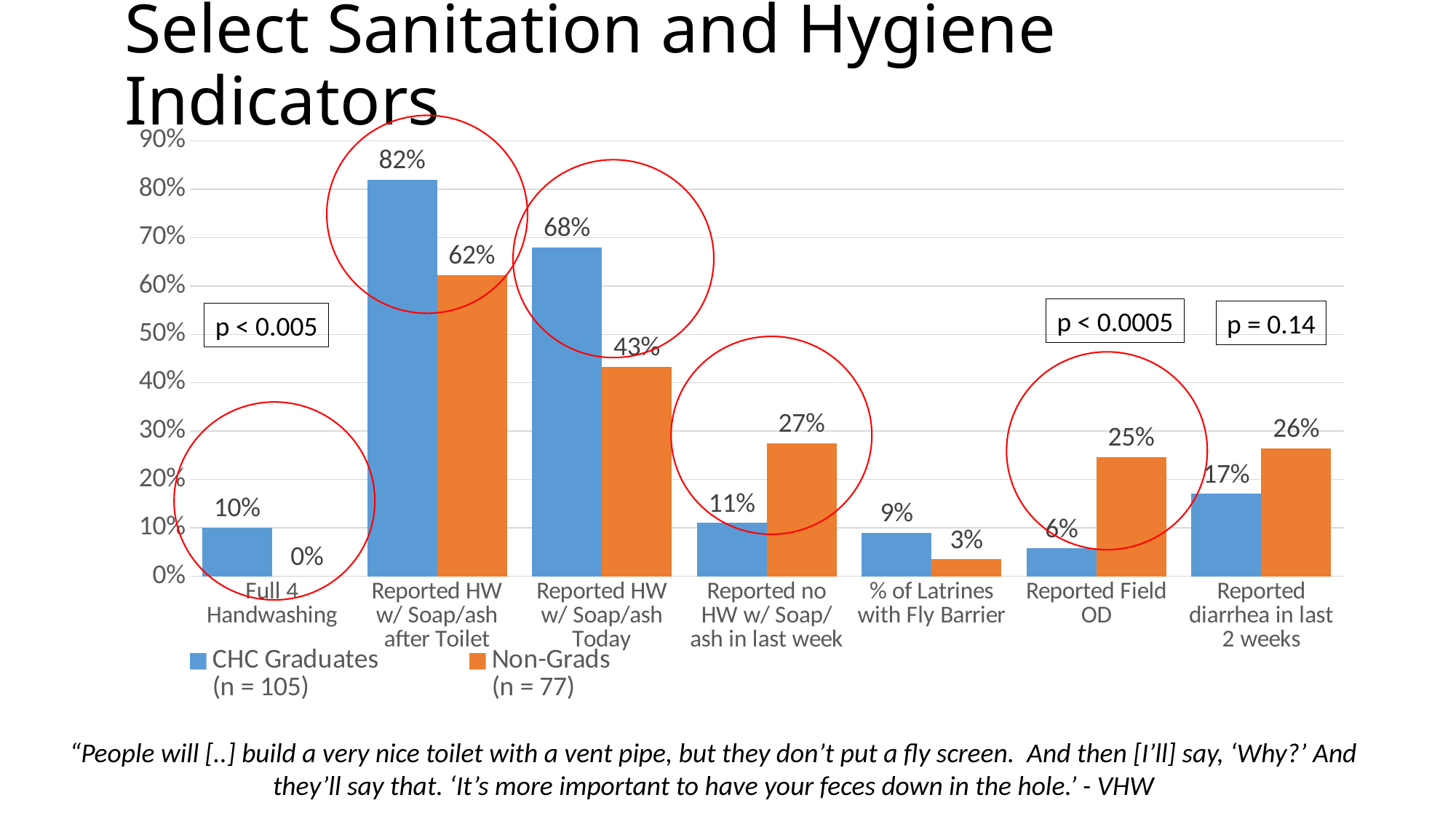
What is the sample size (n) for the CHC Graduates series shown in the legend? 105 What is the difference between CHC Graduates and Non-Grads for Reported HW w/ Soap/ash Today? 25% What is the value for Non-Grads for Full 4 Handwashing? 0% What kind of chart is shown on the slide? Bar chart How many series does the legend list? 2 What is the value for Non-Grads for Reported no HW w/ Soap/ash in last week? 27% Which is larger for Reported Field OD: CHC Graduates or Non-Grads? Non-Grads Which category has the highest value for CHC Graduates? Reported HW w/ Soap/ash after Toilet What is the value for CHC Graduates for Reported HW w/ Soap/ash after Toilet? 82% How many categories are shown on the x axis? 7 Is the value for Non-Grads for Reported HW w/ Soap/ash after Toilet greater or less than 50%? greater Which category has the lowest value for Non-Grads? Full 4 Handwashing